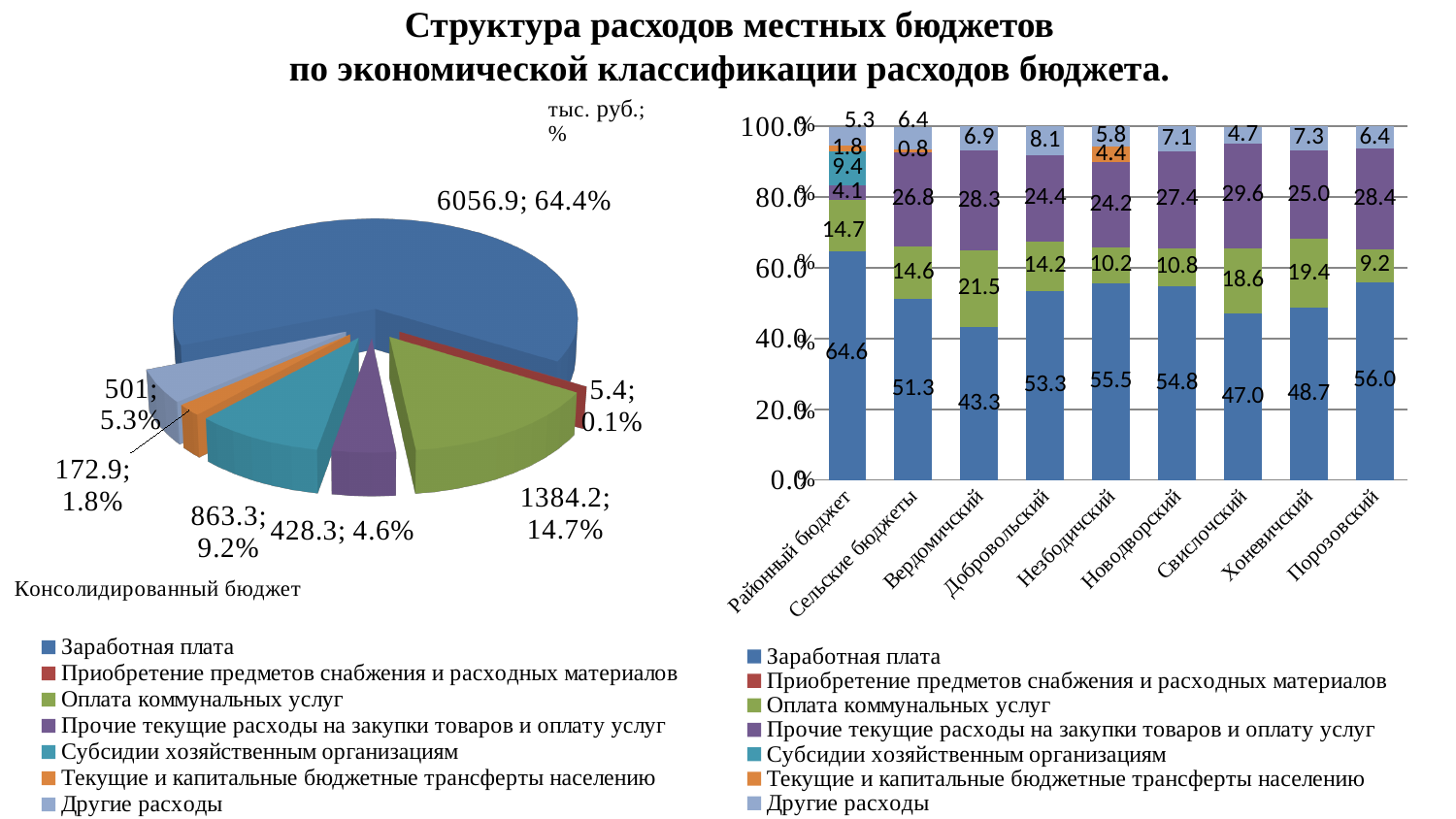
In the right bar chart, what is the difference between the Заработная плата values for Порозовский and Свислочский? 9.0 In the right bar chart, how many budgets are shown on the x axis? 9 In the right bar chart, which has the larger value for Оплата коммунальных услуг: Вердомичский or Хоневичский? Вердомичский In the right bar chart, which budget has the highest value for Заработная плата? Районный бюджет In the pie chart (Консолидированный бюджет), which category has the smallest slice? Приобретение предметов снабжения и расходных материалов What kind of chart is the left chart (Консолидированный бюджет)? Pie chart In the pie chart (Консолидированный бюджет), what share of the total does Оплата коммунальных услуг have? 14.7% In the right bar chart, which budget has the lowest value for Заработная плата? Вердомичский What kind of chart is the right chart with the budgets on the x axis? Stacked bar chart In the right bar chart, how many series does the legend list? 7 In the pie chart (Консолидированный бюджет), what value and share are shown for Заработная плата? 6056.9; 64.4% In the right bar chart, what is the value of Заработная плата for Вердомичский? 43.3